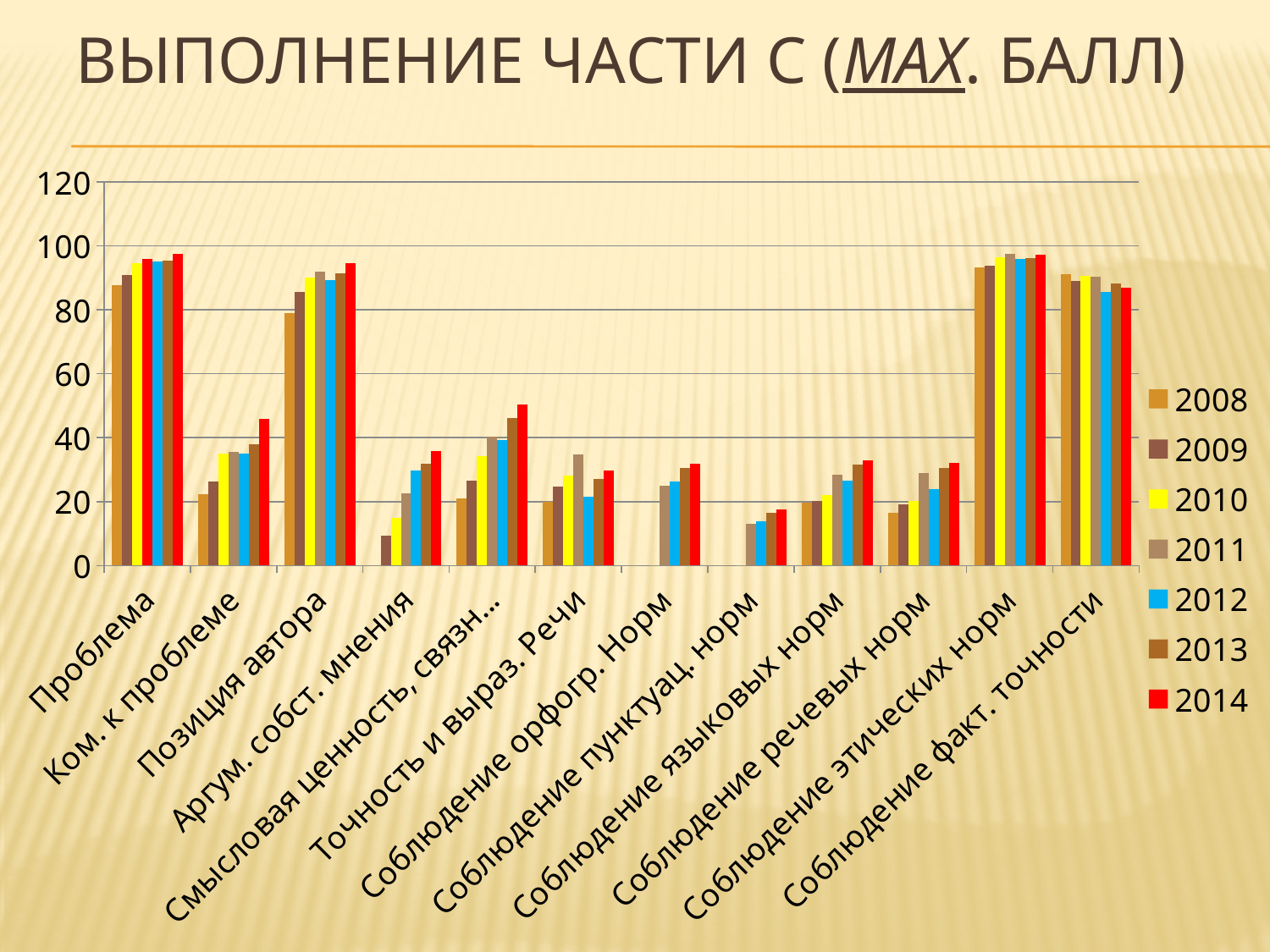
How many series does the legend list? 7 Is the 2014 value for Соблюдение этических норм greater or less than 80? greater Which is larger for 2014: Аргум. собст. мнения or Смысловая ценность, связн...? Смысловая ценность, связн... Is the 2014 value for Соблюдение пунктуац. норм greater or less than 20? less Which category has the lowest 2014 value? Соблюдение пунктуац. норм Which year is shown in red in the legend? 2014 What kind of chart is shown on the slide? bar chart Which is larger for 2014: Проблема or Ком. к проблеме? Проблема What is the first entry in the legend? 2008 How many categories are shown on the x axis? 12 Is the 2010 value for Аргум. собст. мнения greater or less than 20? less